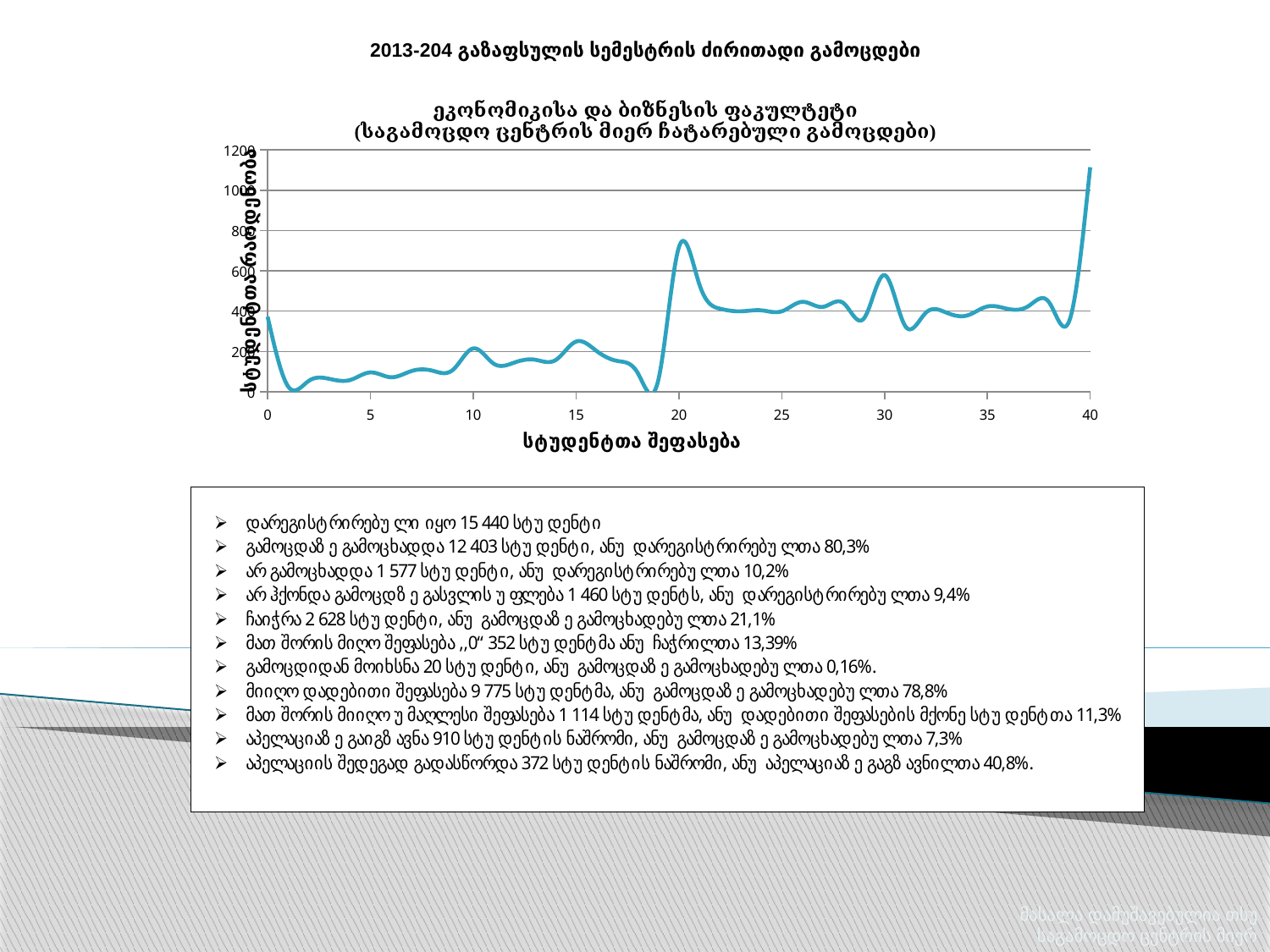
Is the value of the line at x = 20 greater or less than 600? greater What kind of chart is shown on the slide? line chart Is the value of the line at x = 40 greater or less than 1000? greater How many data series are plotted in the chart? 1 Is the value of the line at x = 15 greater or less than 400? less Between x = 35 and x = 40, does the line overall rise or fall? rise What is the label of the x axis of the chart? სტუდენტთა შეფასება Is the value of the line at x = 20 larger or smaller than the value at x = 10? larger What is the title of the chart? ეკონომიკისა და ბიზნესის ფაკულტეტი (საგამოცდო ცენტრის მიერ ჩატარებული გამოცდები) At which x-axis value does the line reach its highest point? 40